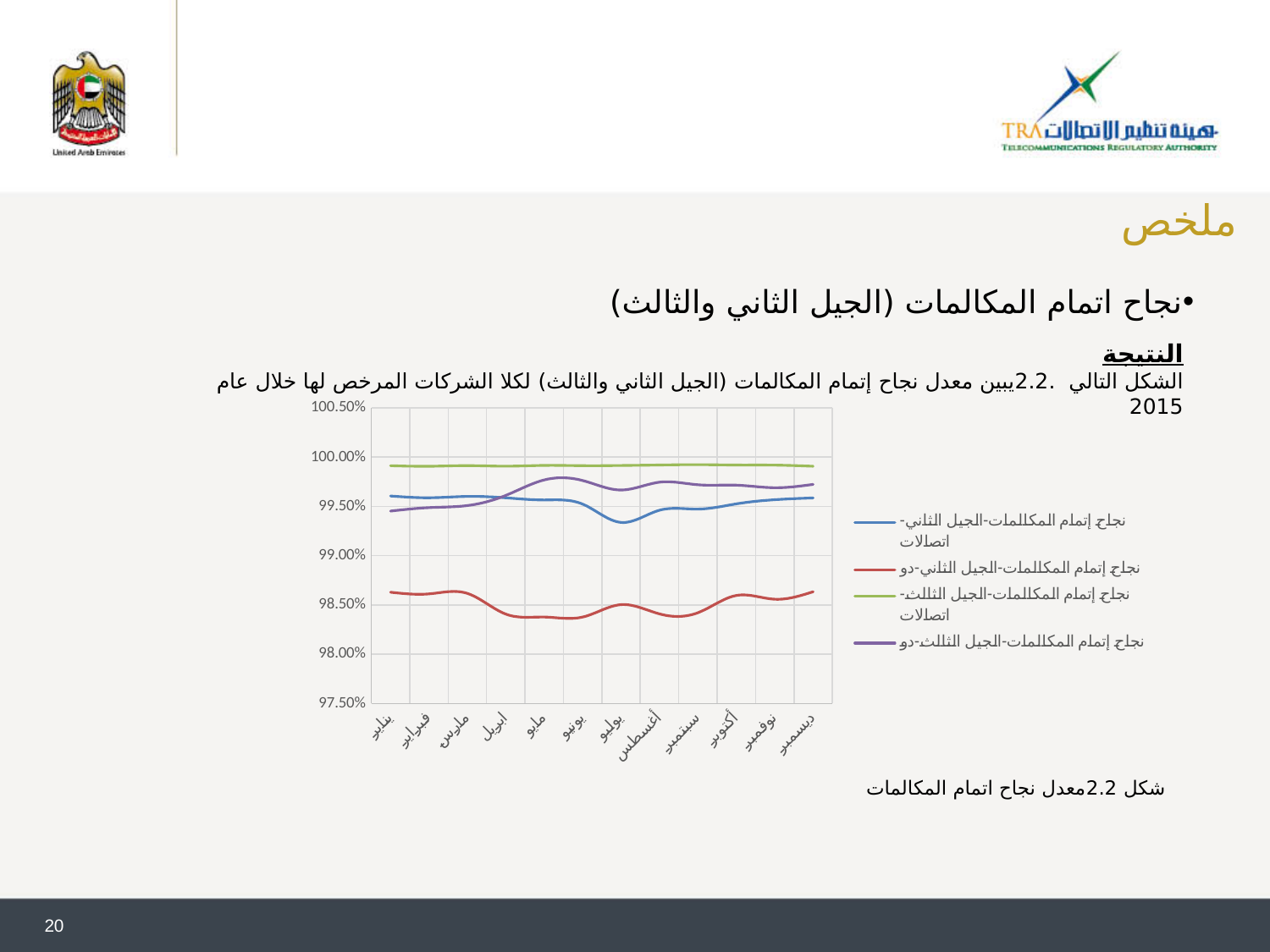
Which series has the lowest values across all months in the chart? نجاح إتمام المكالمات-الجيل الثاني-دو How many months are plotted along the x axis of the chart? 12 Which series has the highest values across all months in the chart? نجاح إتمام المكالمات-الجيل الثالث-اتصالات Is the value for نجاح إتمام المكالمات-الجيل الثاني-اتصالات in يوليو greater or less than 99.50%? less Is the value for نجاح إتمام المكالمات-الجيل الثالث-اتصالات in ديسمبر greater or less than 99.50%? greater In مايو, which is larger: نجاح إتمام المكالمات-الجيل الثاني-اتصالات or نجاح إتمام المكالمات-الجيل الثالث-دو? نجاح إتمام المكالمات-الجيل الثالث-دو Is the value for نجاح إتمام المكالمات-الجيل الثاني-دو in يناير greater or less than 99.00%? less What colour is the line for نجاح إتمام المكالمات-الجيل الثاني-دو in the chart? red Does the line for نجاح إتمام المكالمات-الجيل الثاني-اتصالات rise or fall from يونيو to يوليو? fall How many series does the chart legend list? 4 What kind of chart is shown on the slide? line chart In يناير, which is larger: نجاح إتمام المكالمات-الجيل الثاني-اتصالات or نجاح إتمام المكالمات-الجيل الثالث-دو? نجاح إتمام المكالمات-الجيل الثاني-اتصالات